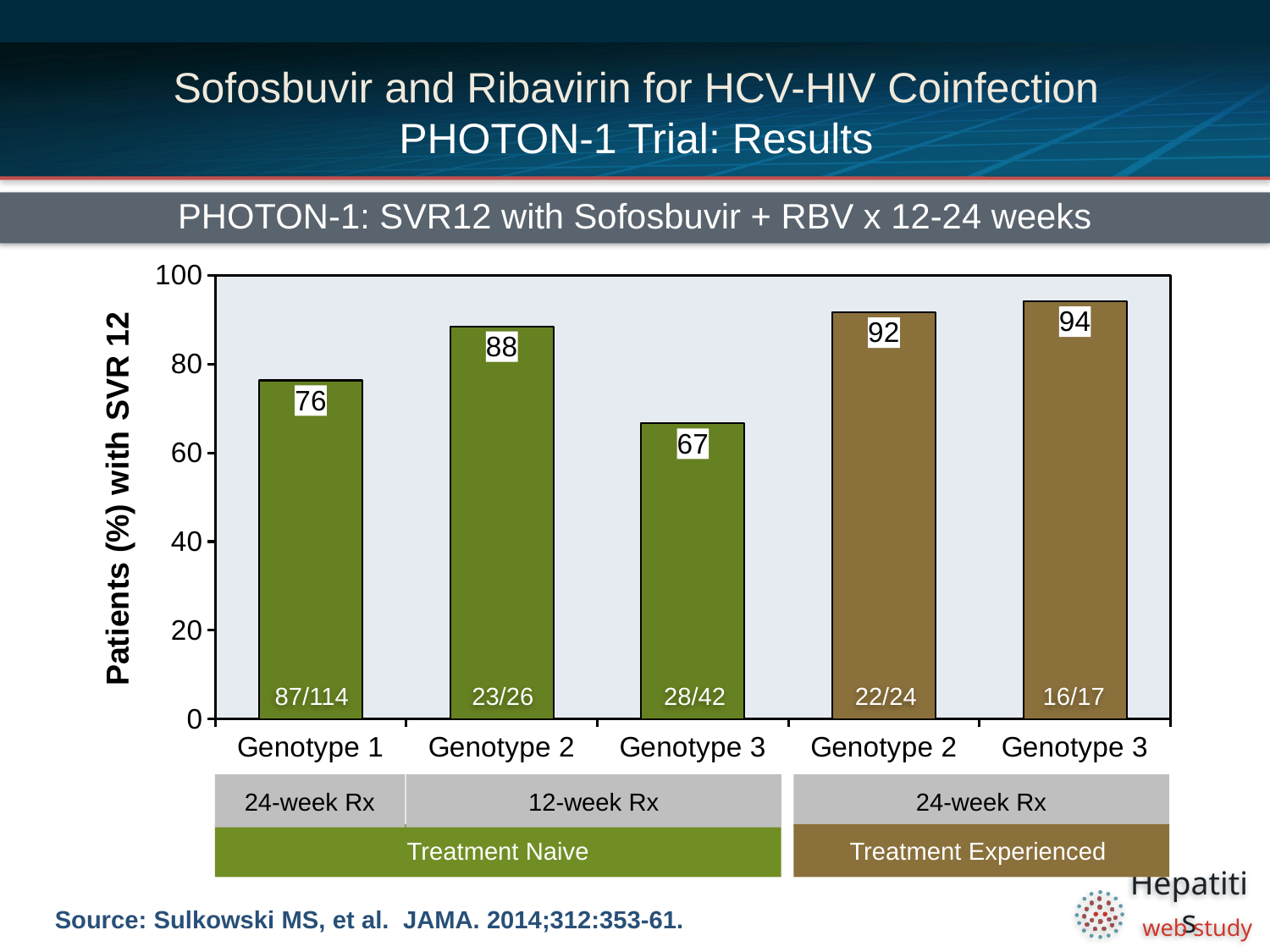
What is the SVR12 rate for Genotype 3 in the treatment-experienced group? 94 What is the difference in SVR12 rate between Genotype 2 treatment-experienced and Genotype 2 treatment-naive? 4 What is the label of the y-axis? Patients (%) with SVR 12 What type of chart is shown on the slide? Bar chart Which is larger: the SVR12 rate for Genotype 3 treatment-naive or Genotype 1 treatment-naive? Genotype 1 treatment-naive Which bar has the highest SVR12 rate? Genotype 3, Treatment Experienced How many bars are plotted in the chart? 5 Which bar has the lowest SVR12 rate? Genotype 3, Treatment Naive Is the SVR12 rate for Genotype 3 in the treatment-naive group greater or less than 80? less What fraction of patients is shown at the base of the Genotype 1 bar? 87/114 What is the SVR12 rate for Genotype 1 in the treatment-naive group? 76 What is the SVR12 rate for Genotype 2 in the treatment-naive (12-week Rx) group? 88